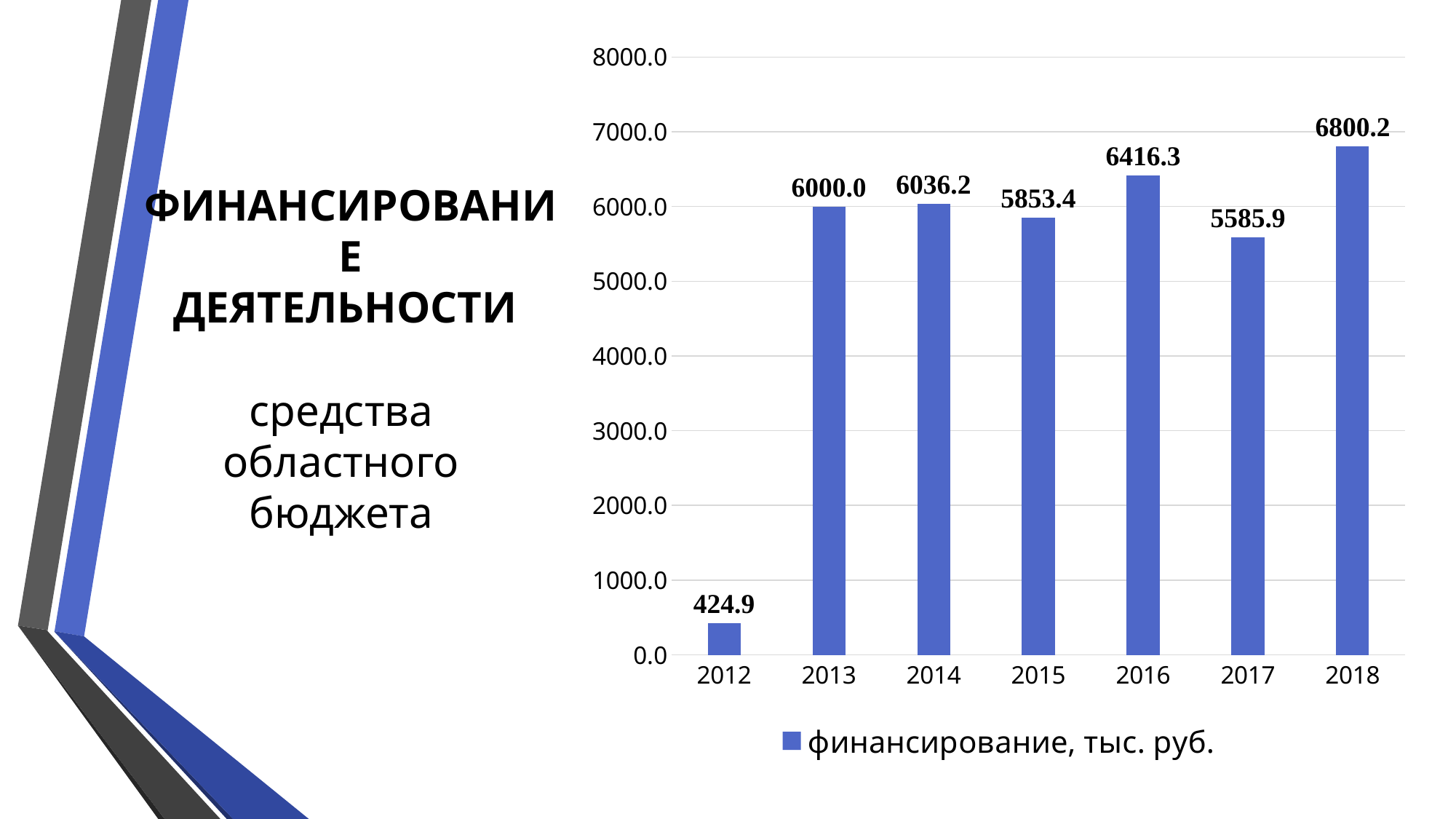
What is the difference between the values for 2016 and 2015? 562.9 Which is larger, the value for 2016 or the value for 2017? 2016 Is the value for 2017 greater or less than 6000? less What kind of chart is shown on the slide? bar chart What is the value for 2015 in the chart? 5853.4 What is the legend entry of the chart? финансирование, тыс. руб. What is the value for 2012 in the chart? 424.9 Which year has the lowest value in the chart? 2012 What is the difference between the values for 2018 and 2017? 1214.3 Which year has the highest value in the chart? 2018 How many years are shown on the x axis of the chart? 7 What is the value for 2018 in the chart? 6800.2